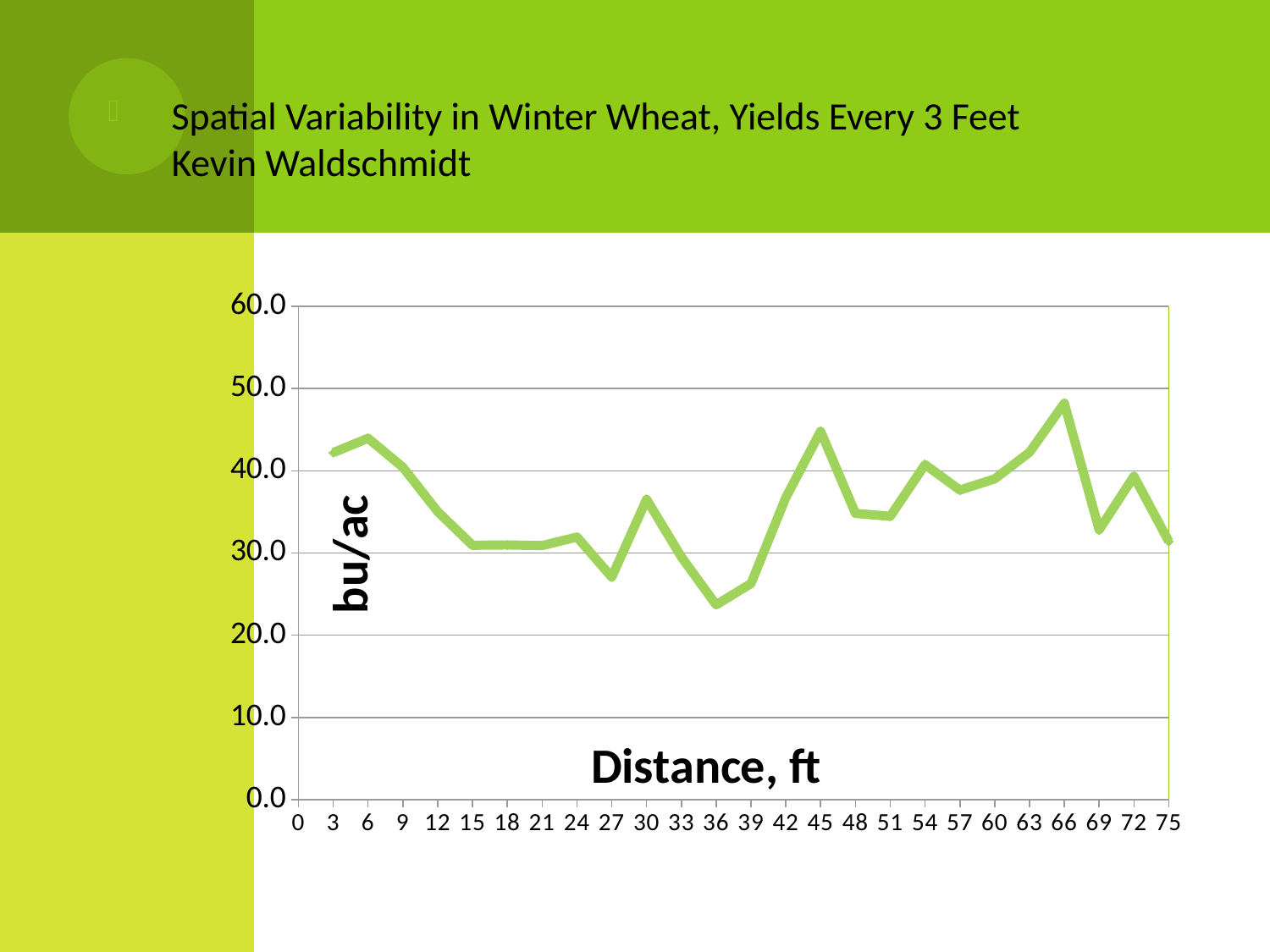
What is the title of the y axis of the chart? bu/ac What kind of chart is shown on the slide? line chart Is the yield at a distance of 57 ft greater or less than 40.0 bu/ac? less What is the title of the x axis of the chart? Distance, ft At which distance does the yield reach its highest value? 66 Does the yield rise or fall between 6 ft and 15 ft? fall Does the yield rise or fall between 36 ft and 45 ft? rise At which distance does the yield reach its lowest value? 36 Is the yield at a distance of 66 ft greater or less than 40.0 bu/ac? greater Which distance has the higher yield, 45 ft or 36 ft? 45 ft Is the yield at a distance of 36 ft greater or less than 30.0 bu/ac? less